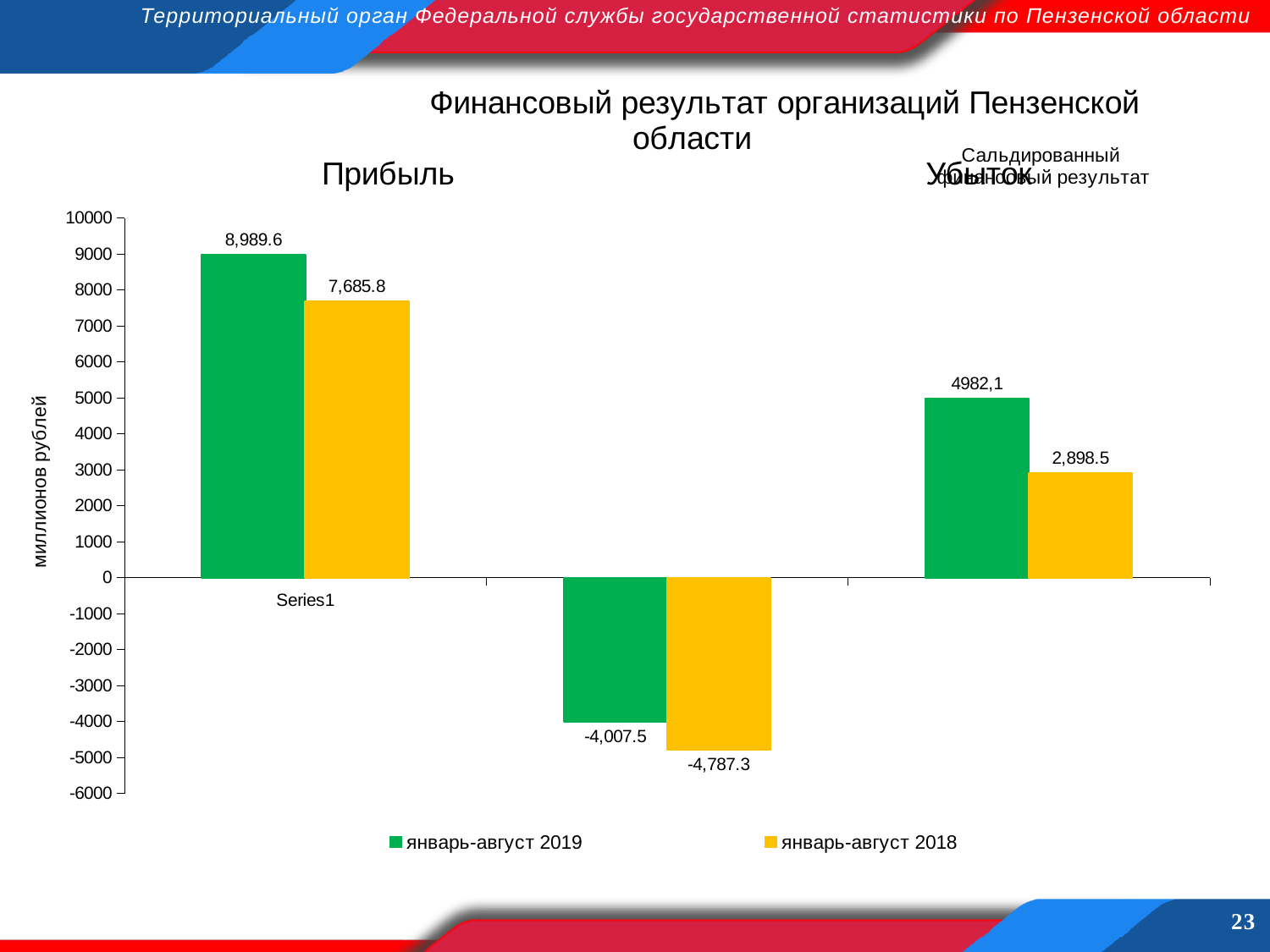
What is the value for январь-август 2018 in the Убыток group? -4,787.3 What is the value for январь-август 2018 in the Прибыль group? 7,685.8 What is the difference between the январь-август 2019 and январь-август 2018 values in the Прибыль group? 1,303.8 What type of chart is shown on the slide? Bar chart What is the label of the vertical axis? миллионов рублей Which series has the larger value in the Прибыль group, январь-август 2019 or январь-август 2018? январь-август 2019 How many series does the legend list? 2 What is the value for январь-август 2019 in the Прибыль group? 8,989.6 Which group has the highest value for январь-август 2019? Прибыль What is the value for январь-август 2018 in the Сальдированный финансовый результат group? 2,898.5 What is the value for январь-август 2019 in the Сальдированный финансовый результат group? 4982,1 What is the value for январь-август 2019 in the Убыток group? -4,007.5